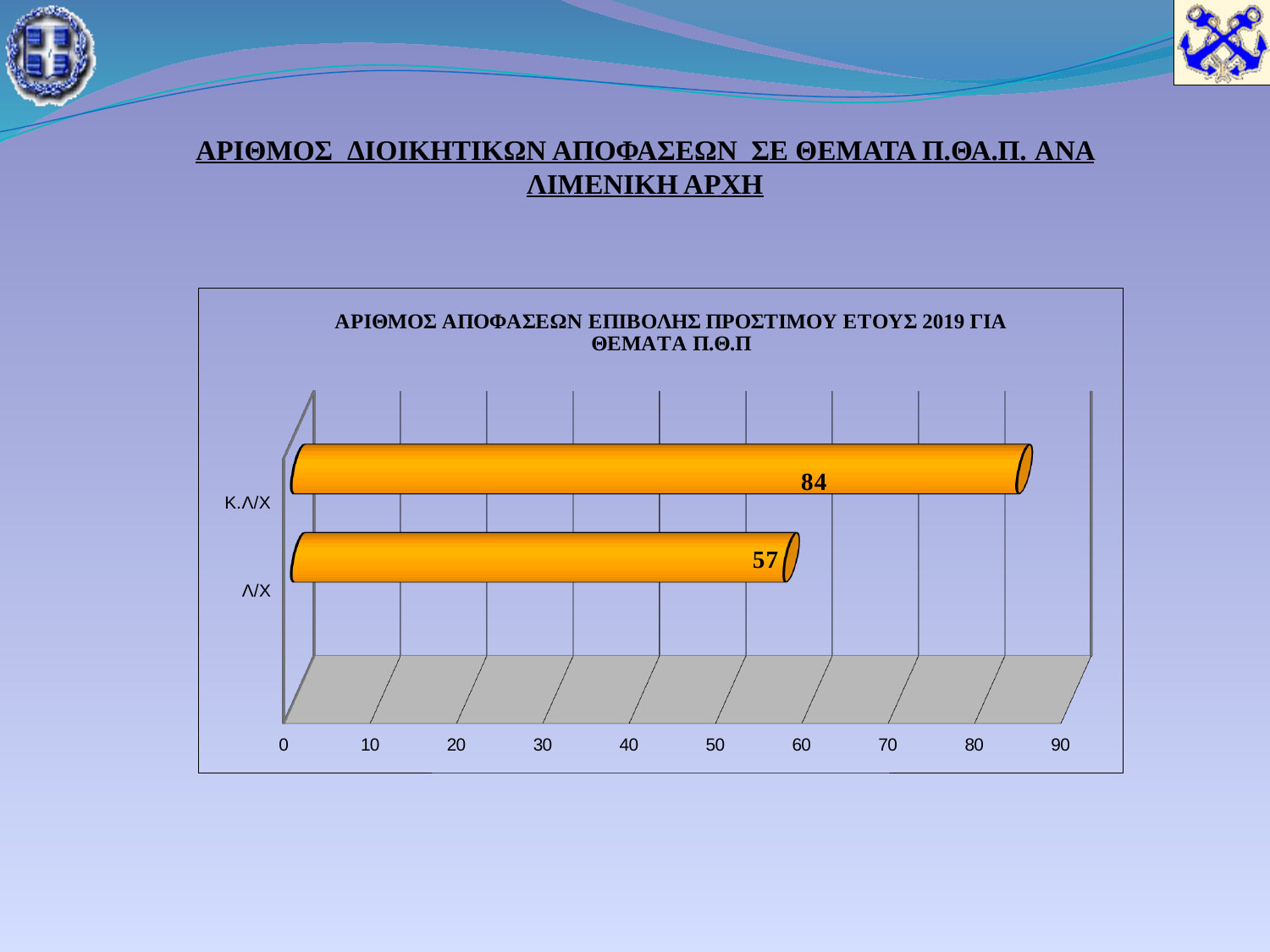
What kind of chart is shown on the slide? bar chart What is the difference between the values for Κ.Λ/Χ and Λ/Χ? 27 What is the title of the chart? ΑΡΙΘΜΟΣ ΑΠΟΦΑΣΕΩΝ ΕΠΙΒΟΛΗΣ ΠΡΟΣΤΙΜΟΥ ΕΤΟΥΣ 2019 ΓΙΑ ΘΕΜΑΤΑ Π.Θ.Π Is the value for Κ.Λ/Χ greater or less than 80? greater Which category has the highest value? Κ.Λ/Χ What is the value for Λ/Χ? 57 Is the value for Λ/Χ greater or less than 60? less Which is larger, the value for Κ.Λ/Χ or the value for Λ/Χ? Κ.Λ/Χ Which category has the lowest value? Λ/Χ What is the maximum value shown on the horizontal axis of the chart? 90 How many categories are shown in the chart? 2 What is the value for Κ.Λ/Χ? 84